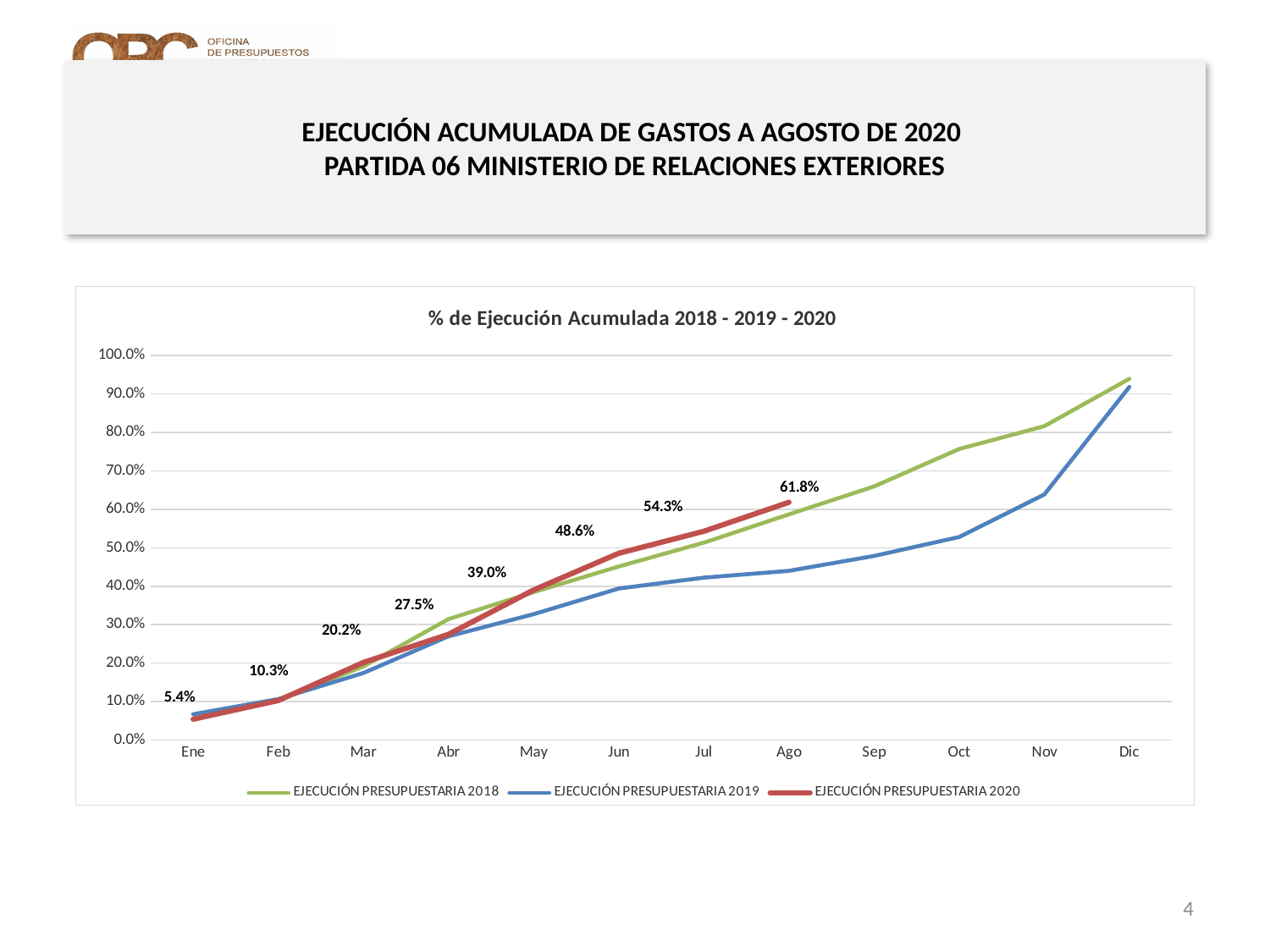
What kind of chart is shown on the slide? line chart What is the value for EJECUCIÓN PRESUPUESTARIA 2020 in Ago? 61.8% What is the difference between the EJECUCIÓN PRESUPUESTARIA 2020 values for Ago and Jul? 7.5% What is the difference between the EJECUCIÓN PRESUPUESTARIA 2020 values for Jun and Abr? 21.1% What is the value for EJECUCIÓN PRESUPUESTARIA 2020 in Ene? 5.4% Does the EJECUCIÓN PRESUPUESTARIA 2020 line rise or fall from Ene to Ago? rise What is the value for EJECUCIÓN PRESUPUESTARIA 2020 in May? 39.0% How many months are shown on the x axis? 12 Which series is higher in Oct, EJECUCIÓN PRESUPUESTARIA 2018 or EJECUCIÓN PRESUPUESTARIA 2019? EJECUCIÓN PRESUPUESTARIA 2018 Is the value for EJECUCIÓN PRESUPUESTARIA 2019 in Dic greater or less than 80.0%? greater How many series does the legend list? 3 What is the value for EJECUCIÓN PRESUPUESTARIA 2020 in Mar? 20.2%